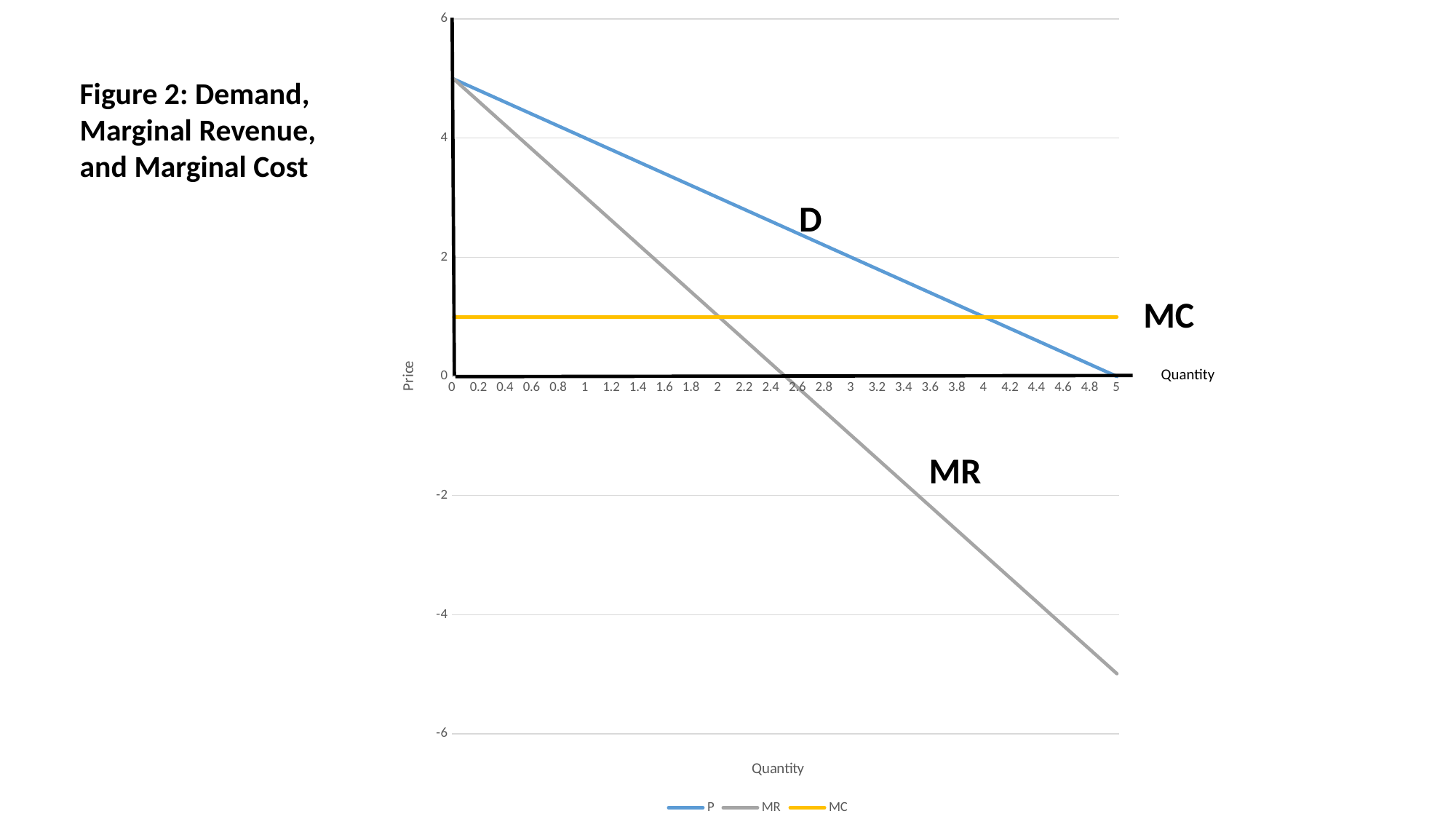
Does the MR line rise or fall as quantity increases? fall What kind of chart is shown on the slide? line chart At quantity 3, which line has the higher value, D or MR? D How many series does the legend list? 3 Is the value of the MC line greater or less than 2? less What is the title of the figure on the slide? Figure 2: Demand, Marginal Revenue, and Marginal Cost Is the value of the MR line at quantity 4 greater or less than -2? less What is the value of the D (P) line at quantity 5? 0 What are the series names listed in the legend? P, MR, MC Is the value of the D line at quantity 0 greater or less than 4? greater